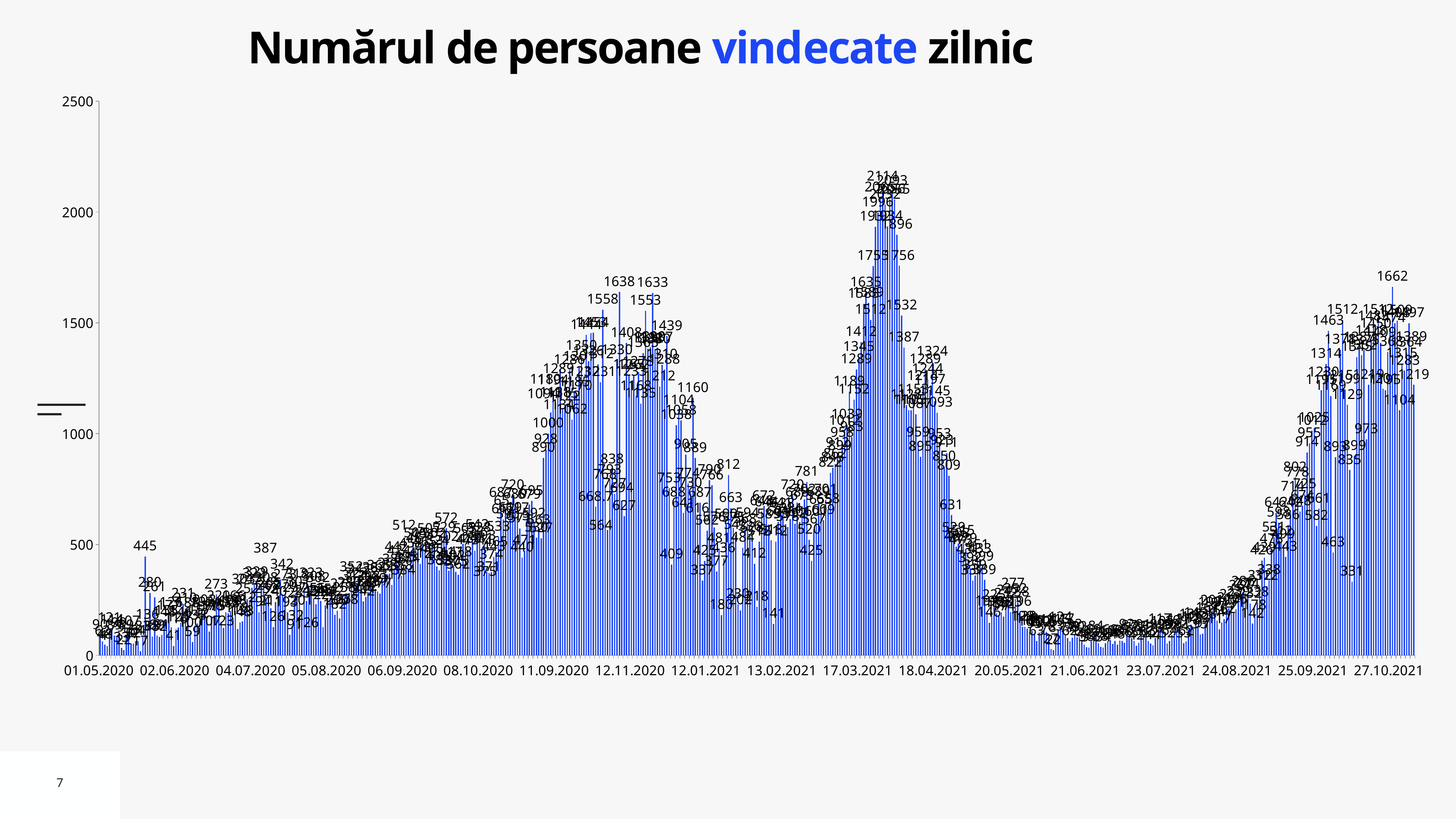
Do the values rise or fall between 18.04.2021 and 20.05.2021? fall What is the value of the spike labeled just after 04.07.2020? 387 Is the highest bar, near 17.03.2021, greater or less than 2000? greater What is the value of the tallest bar near 27.10.2021? 1662 Which peak is higher: the one in March 2021 (labeled 2114) or the one in November 2020 (labeled 1638)? March 2021 (2114) What is the highest value labeled on the chart? 2114 What is the title of the chart? Numărul de persoane vindecate zilnic Do the values rise or fall between 21.06.2021 and 27.10.2021? rise What is the value of the isolated spike shortly before 02.06.2020? 445 Are the bars around 21.06.2021 greater or less than 500? less What is the difference between the March 2021 peak of 2114 and the October 2021 peak of 1662? 452 What kind of chart is shown on the slide? bar chart